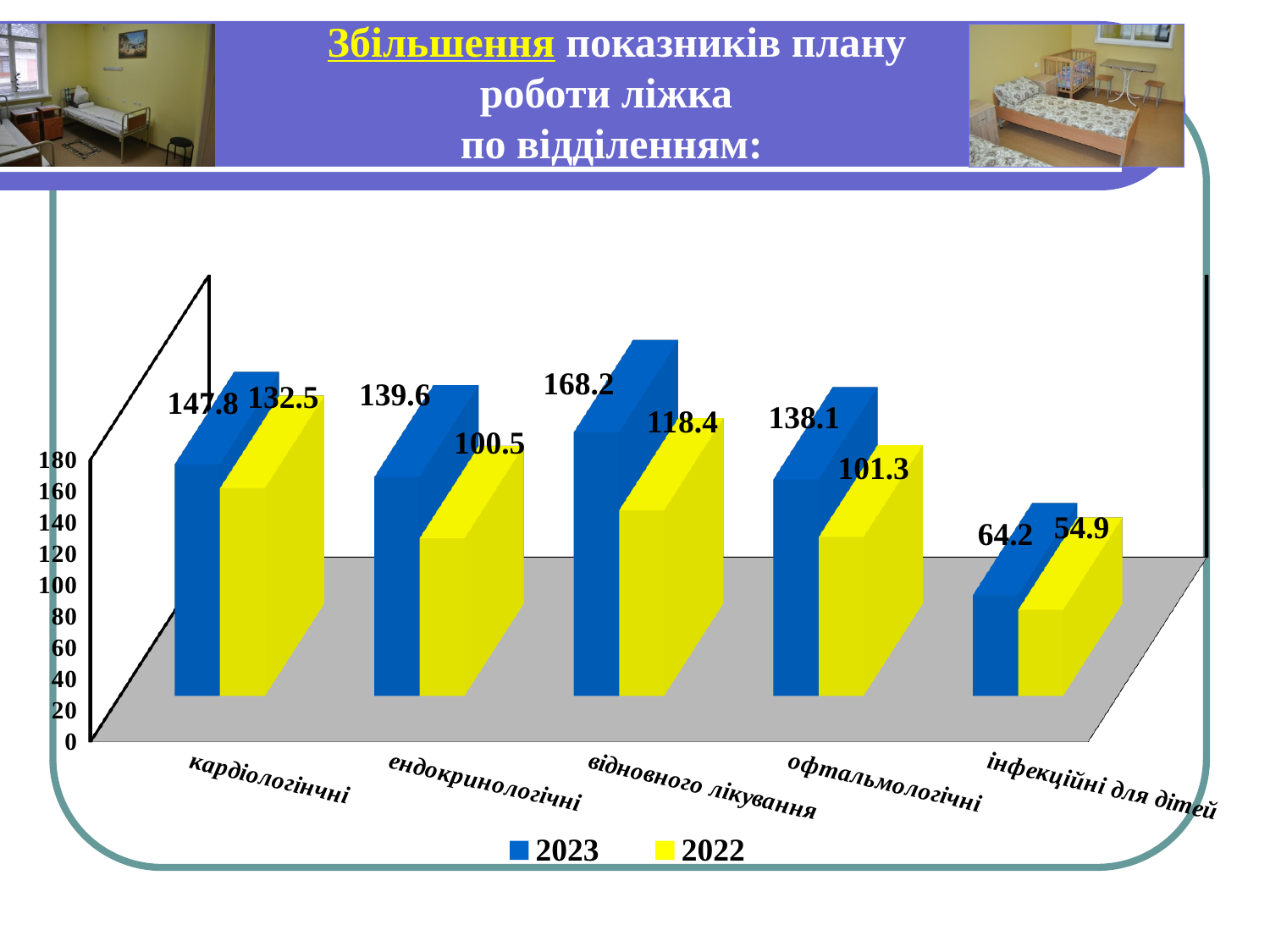
What is the 2022 value for офтальмологічні? 101.3 Which is larger for ендокринологічні: the 2023 value or the 2022 value? 2023 Which department has the highest 2023 value? відновного лікування Which department has the lowest 2022 value? інфекційні для дітей How many departments are shown on the x axis? 5 Which colour represents the 2022 series in the legend? yellow How many series does the legend list? 2 What is the 2022 value for ендокринологічні? 100.5 What is the 2023 value for відновного лікування? 168.2 What is the difference between the 2023 and 2022 values for кардіологінчні? 15.3 What is the 2023 value for інфекційні для дітей? 64.2 What kind of chart is shown on the slide? bar chart